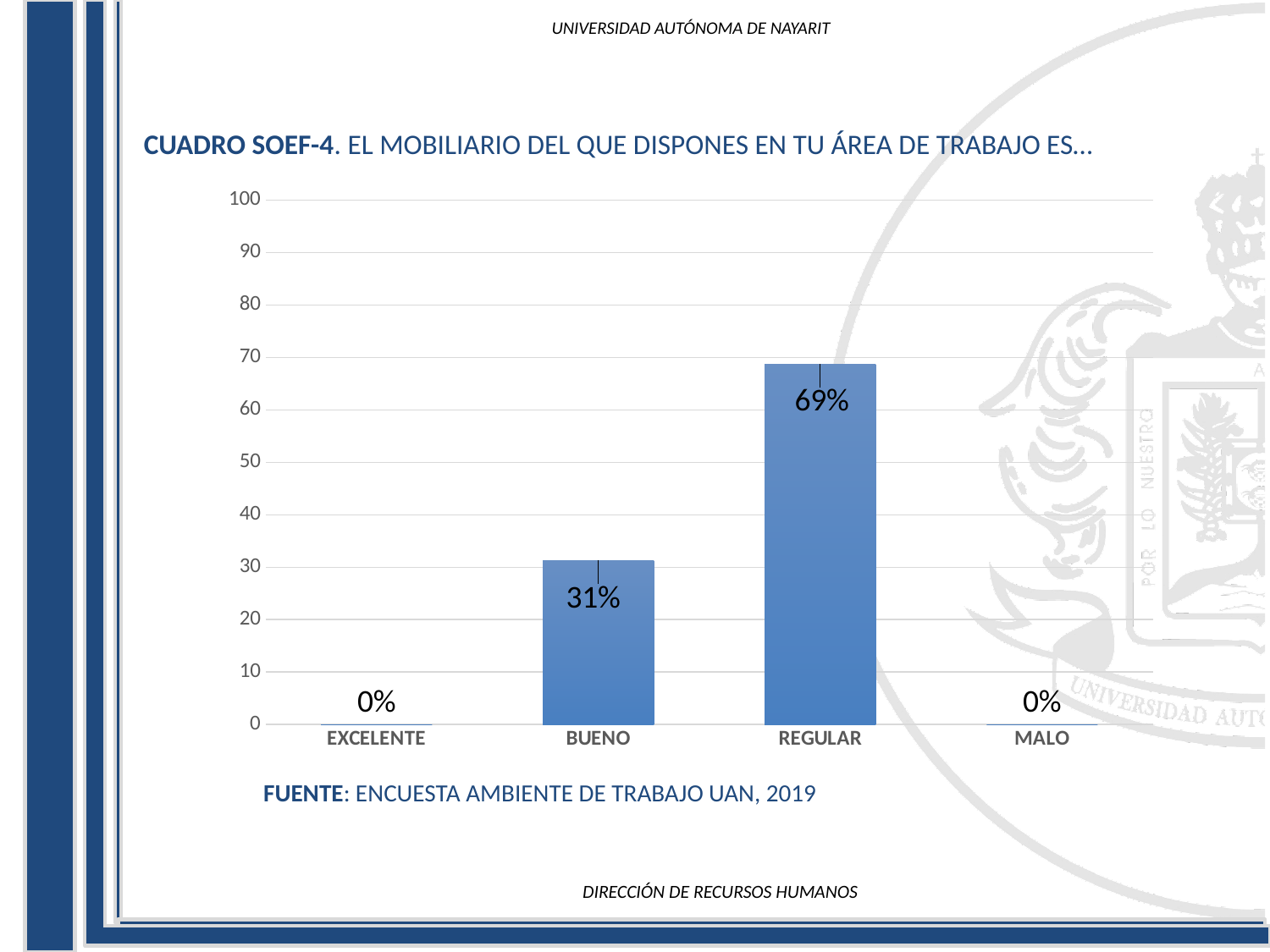
What is the source cited below the chart? ENCUESTA AMBIENTE DE TRABAJO UAN, 2019 How many categories are shown on the x axis? 4 What is the difference between the values for REGULAR and BUENO? 38% Which category has the highest value? REGULAR What is the value for BUENO? 31% Is the value for BUENO greater or less than 40? less What is the value for EXCELENTE? 0% What is the value for MALO? 0% Which is larger, the value for BUENO or the value for REGULAR? REGULAR What kind of chart is shown on the slide? bar chart What is the value for REGULAR? 69% Is the value for REGULAR greater or less than 60? greater